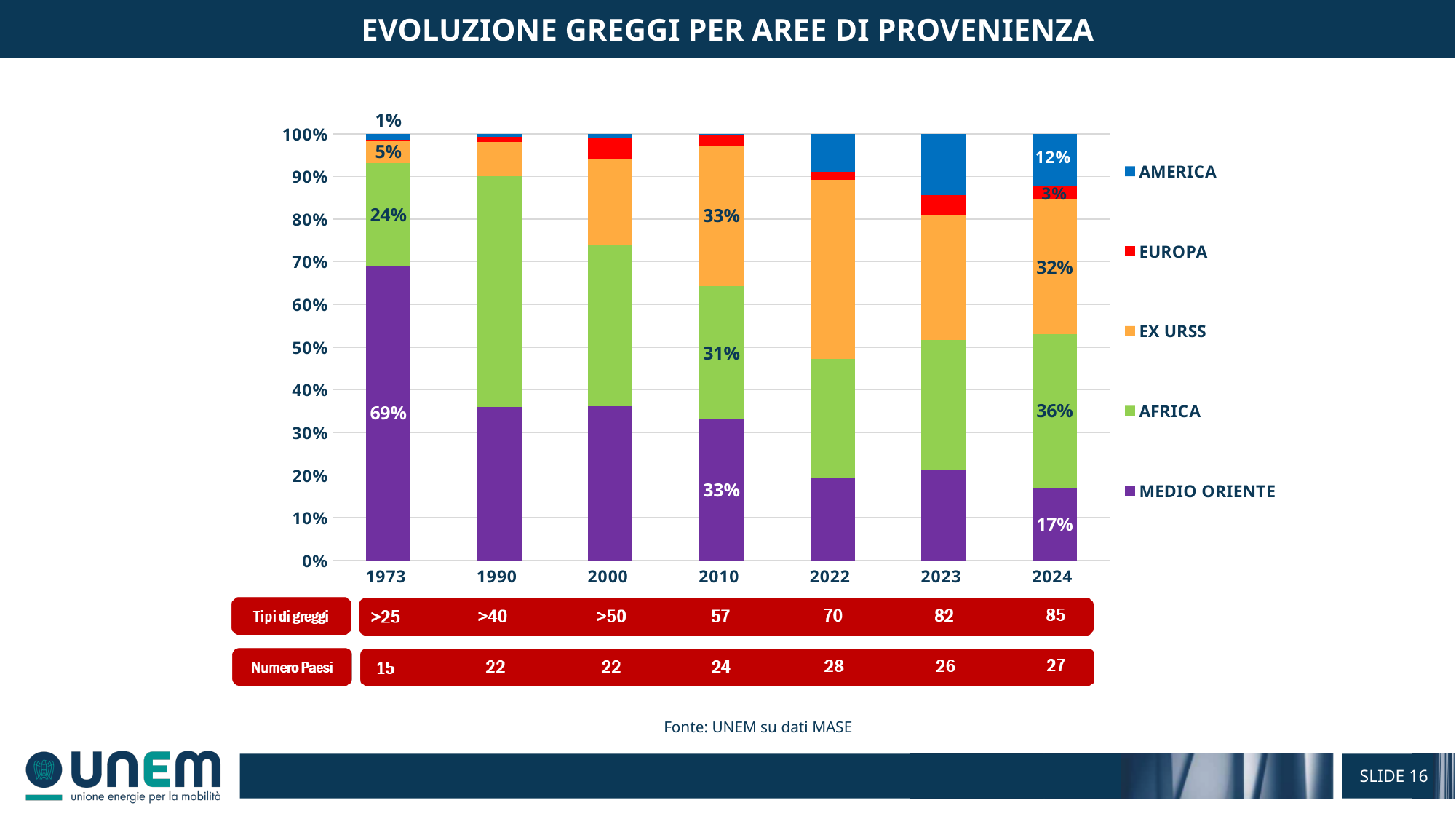
Which colour represents EX URSS in the legend? orange How many years are shown on the x axis? 7 What is the share of MEDIO ORIENTE in 1973? 69% What is the share of AFRICA in 2024? 36% What is the difference between the MEDIO ORIENTE share in 1973 and in 2024? 52% How many series does the legend list? 5 Does the MEDIO ORIENTE share rise or fall from 1973 to 2024? fall Is the MEDIO ORIENTE share in 2022 greater or less than 30%? less Which is larger in 2024, the share of AFRICA or the share of EX URSS? AFRICA What kind of chart is shown on the slide? stacked bar chart What is the share of AMERICA in 2024? 12% What is the share of EX URSS in 2010? 33%